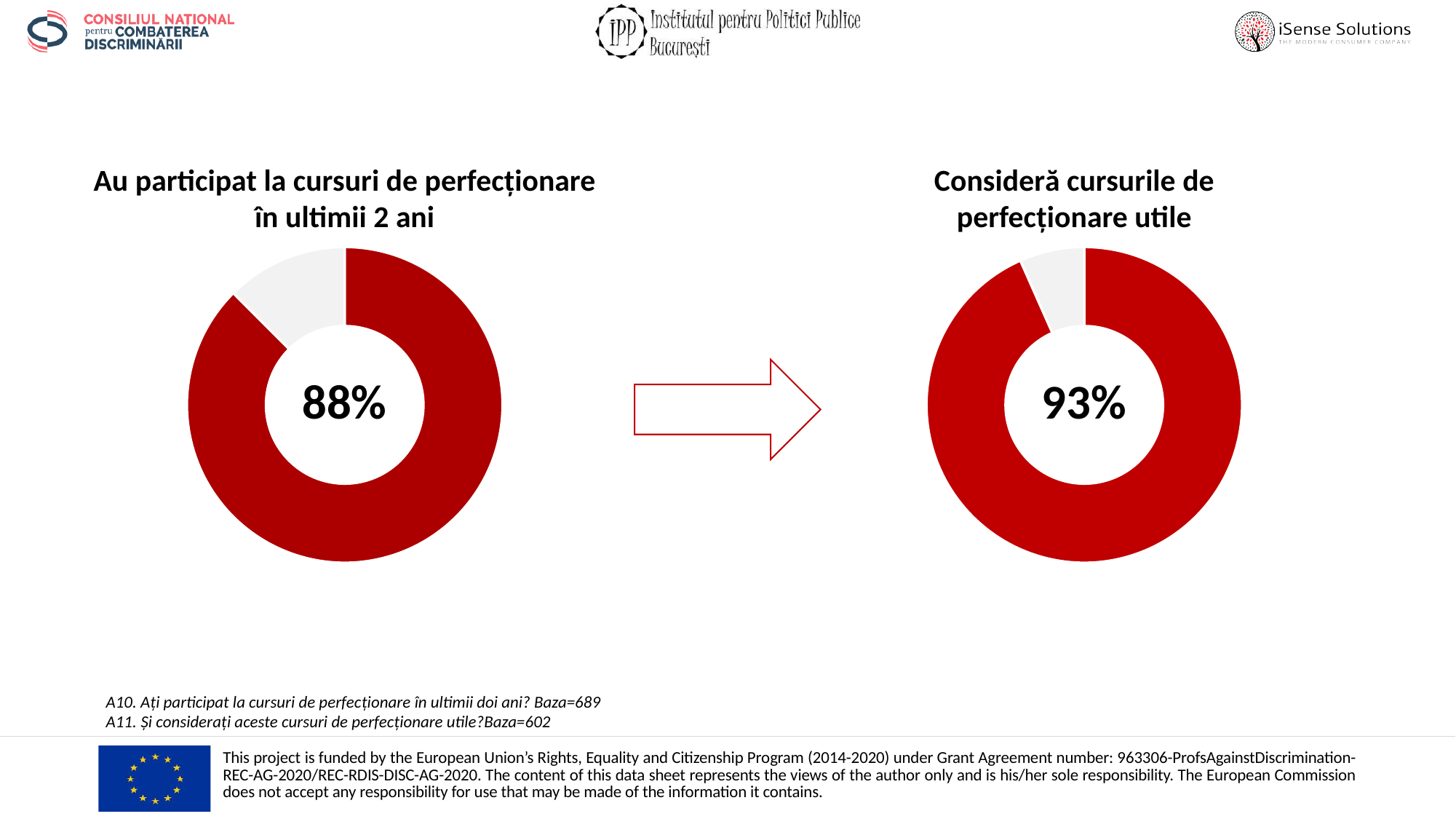
What is the difference in percentage points between the value in the right chart (93%) and the value in the left chart (88%)? 5 percentage points In the left donut chart, what share of the ring is taken by the red slice? 88% In the right donut chart, 'Consideră cursurile de perfecționare utile', what percentage is shown in the centre? 93% What kind of chart is used on the left side of the slide? Donut (pie) chart In the left donut chart, 'Au participat la cursuri de perfecționare în ultimii 2 ani', what percentage is shown in the centre? 88% In the right donut chart, what share of the ring is taken by the grey (non-red) slice? 7% What is the title of the right donut chart? Consideră cursurile de perfecționare utile Is the value shown in the left donut chart greater or less than 90%? less How many slices does the left donut chart have? 2 Which chart shows the higher percentage, the left one ('Au participat la cursuri de perfecționare în ultimii 2 ani') or the right one ('Consideră cursurile de perfecționare utile')? The right one (93%) What colour is the larger slice in both donut charts? Red How many slices does the right donut chart have? 2